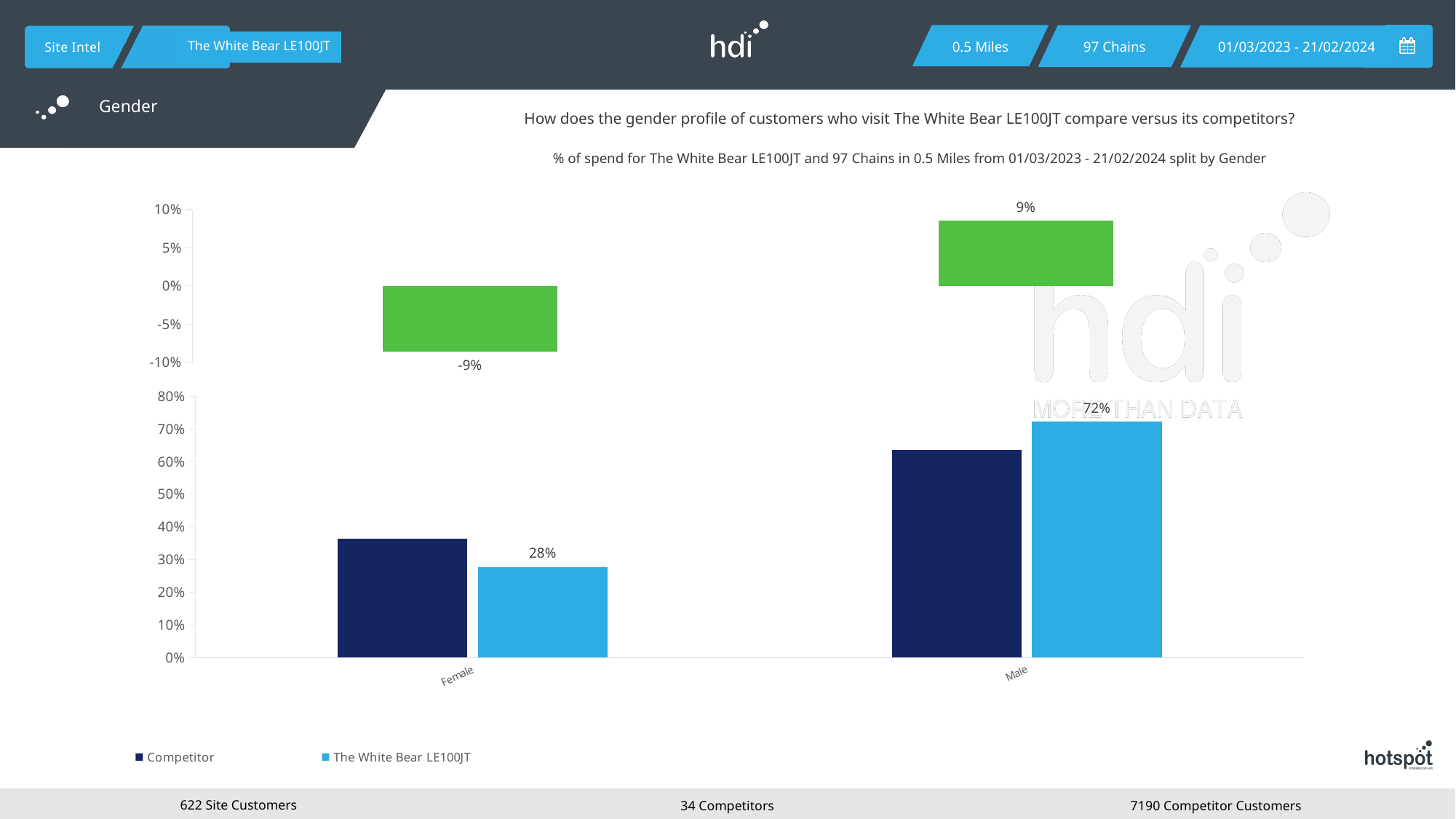
In the bottom chart, which series has the larger value for Male, Competitor or The White Bear LE100JT? The White Bear LE100JT In the bottom chart, what is the value for The White Bear LE100JT for Female? 28% In the bottom chart, what is the value for The White Bear LE100JT for Male? 72% How many categories are shown on the x axis of the bottom chart? 2 How many series does the legend of the bottom chart list? 2 In the bottom chart, what is the difference between The White Bear LE100JT's Male and Female values? 44% In the bottom chart, is the Competitor value for Male greater or less than 70%? less In the bottom chart, is the Competitor value for Female greater or less than 30%? greater What type of chart is the bottom chart? Bar chart In the top chart, what is the value shown for Male? 9% In the bottom chart, which series has the larger value for Female, Competitor or The White Bear LE100JT? Competitor In the top chart, what is the value shown for Female? -9%